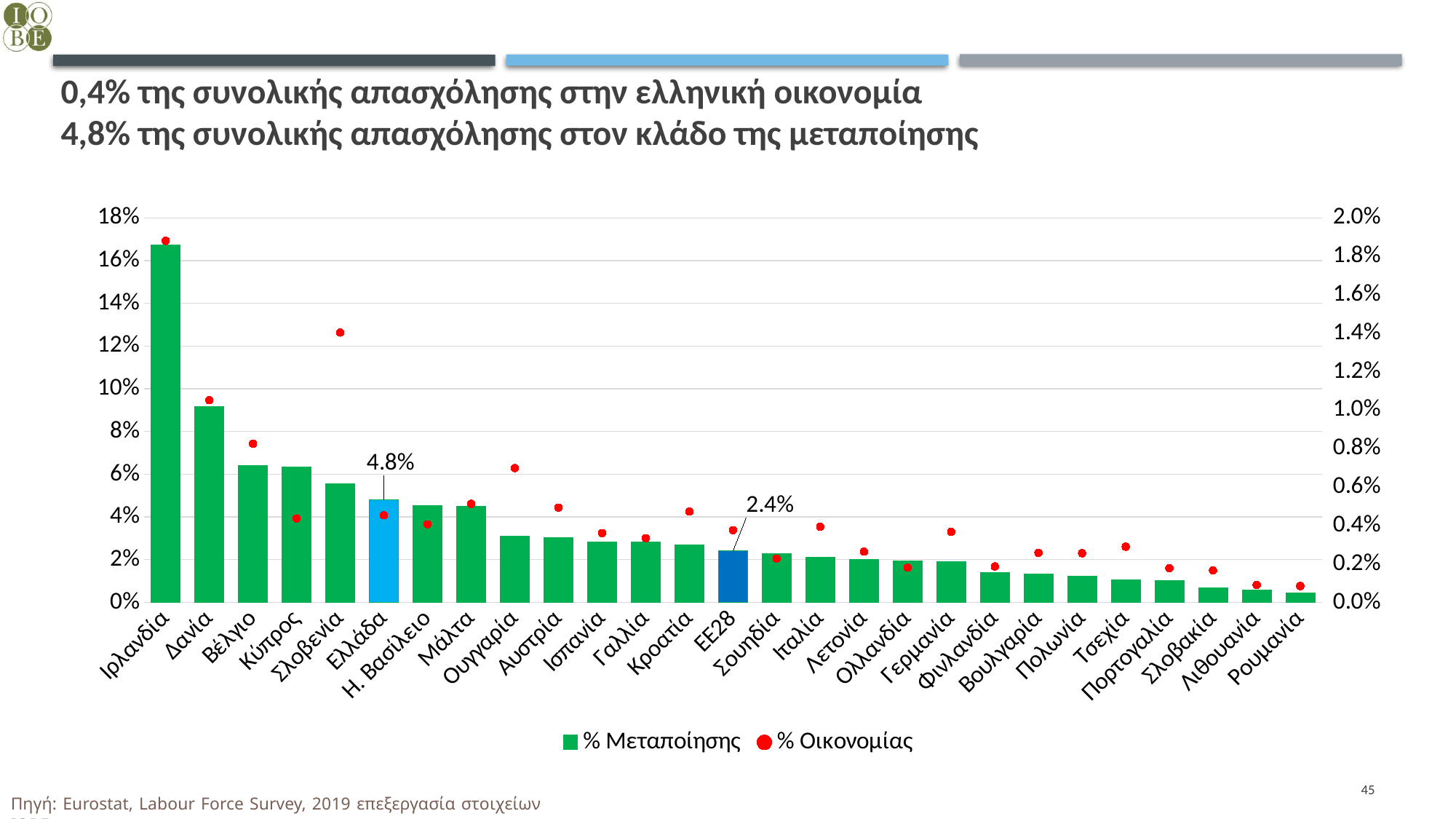
What is the value of the % Μεταποίησης bar for ΕΕ28? 2.4% Do the % Μεταποίησης bars rise or fall from left to right along the x axis? Fall Is the % Μεταποίησης value for Ιρλανδία greater or less than 16%? greater Is the % Μεταποίησης value for Δανία greater or less than 10%? less How many countries/categories are shown on the x axis? 27 What kind of chart is this? Bar chart with dot markers for a second series What is the difference between the % Μεταποίησης values for Ελλάδα and ΕΕ28? 2.4% How many series does the legend list? 2 Which country has the highest % Μεταποίησης bar? Ιρλανδία Which has the larger % Μεταποίησης bar, Δανία or Βέλγιο? Δανία Which country has the highest % Οικονομίας marker? Ιρλανδία What is the value of the % Μεταποίησης bar for Ελλάδα? 4.8%